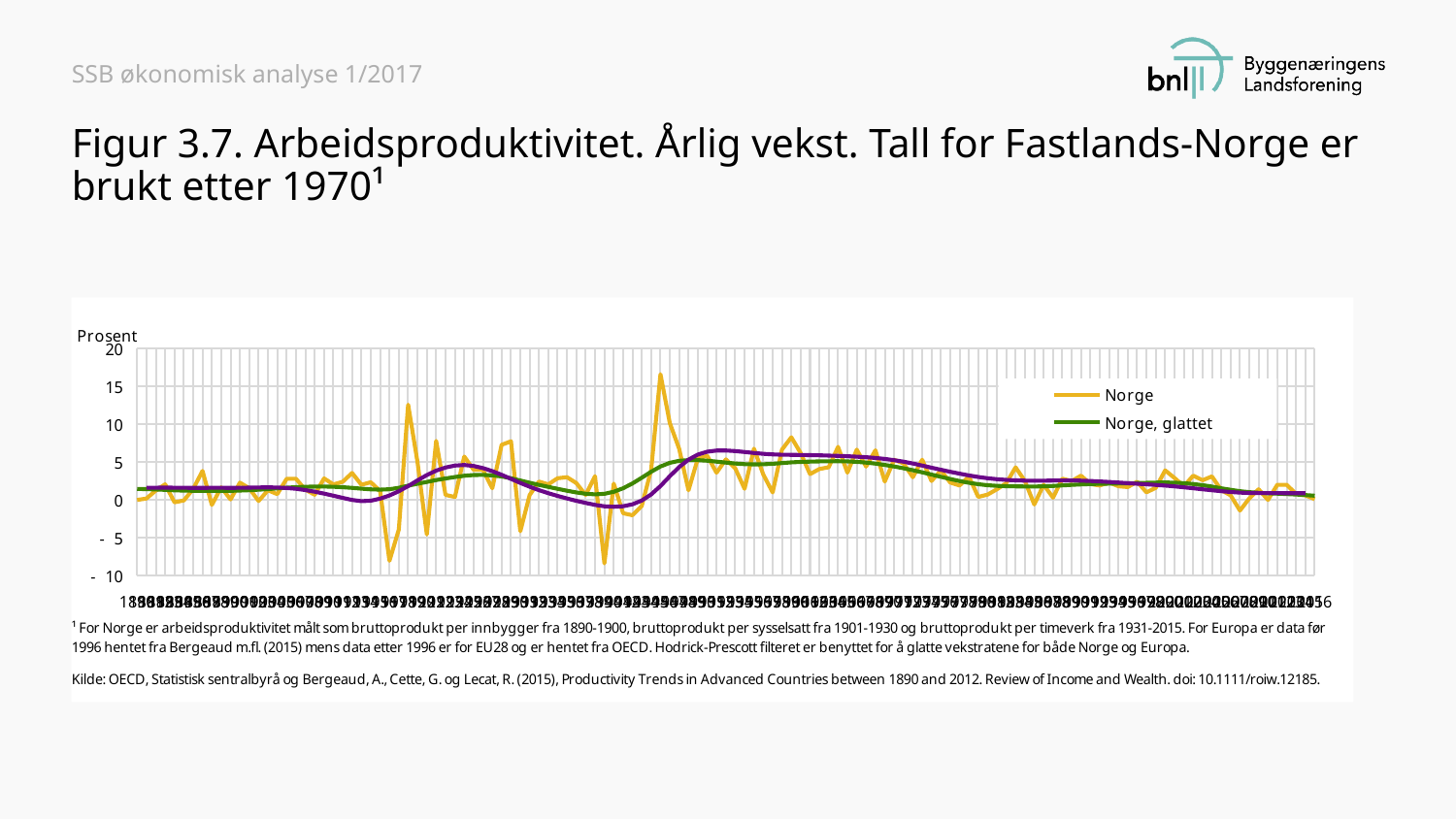
Is the highest point of the Norge, glattet series greater or less than 10? less What is the lowest value shown on the vertical axis of the chart? -10 What kind of chart is shown on the slide? Line chart Is the lowest point of the Norge series greater or less than -5? less What are the two series named in the chart's legend? Norge; Norge, glattet How many series does the chart's legend list? 2 What is the title of the vertical axis of the chart? Prosent Which series is drawn in green in the chart? Norge, glattet Is the highest peak of the Norge series greater or less than 15? greater Which series shows larger year-to-year fluctuations, Norge or Norge, glattet? Norge What is the highest value shown on the vertical axis of the chart? 20